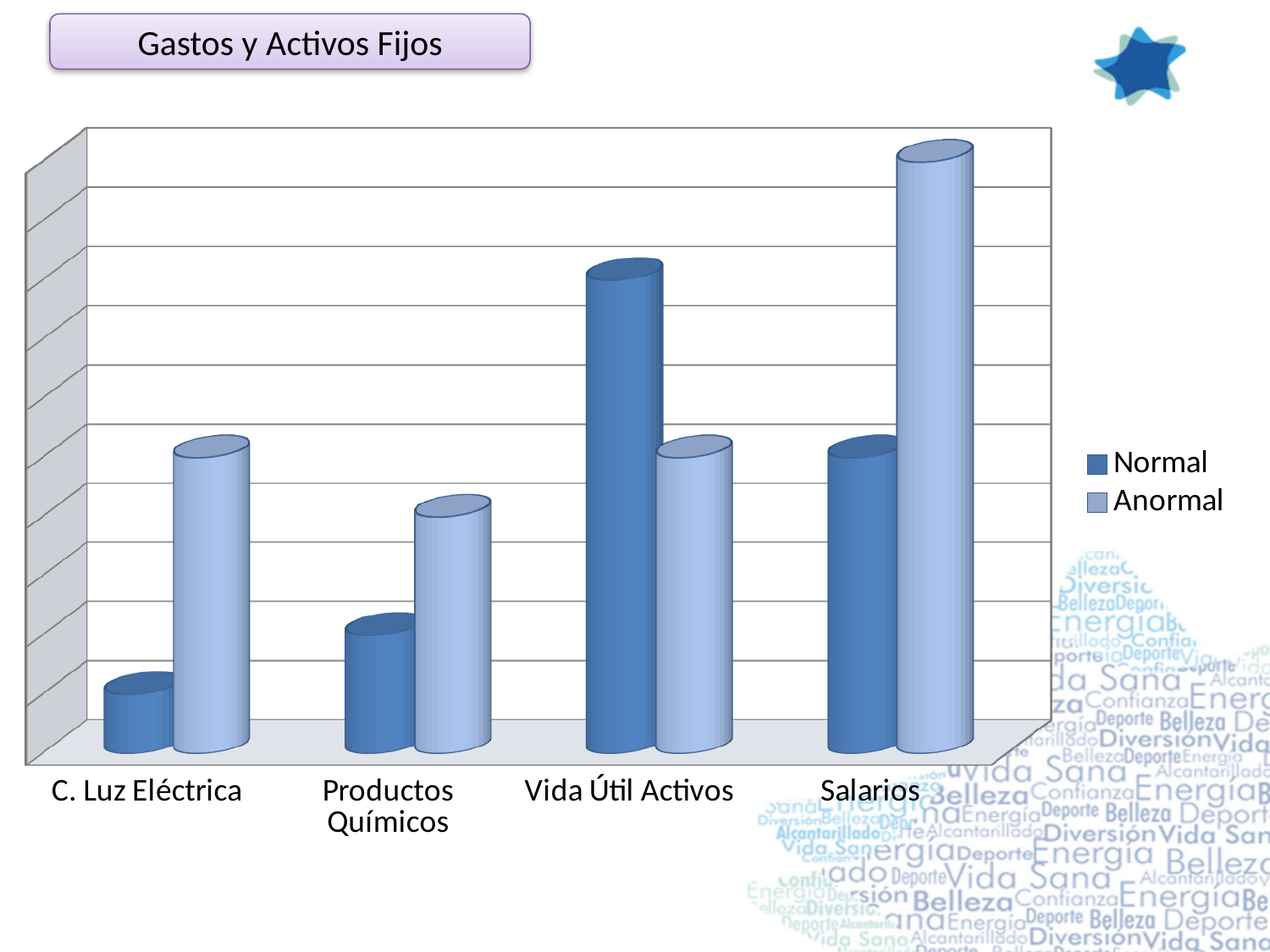
Which category has the highest Normal value? Vida Útil Activos For C. Luz Eléctrica, which is larger, the Normal value or the Anormal value? Anormal What kind of chart is shown on the slide? bar chart Which category has the lowest Normal value? C. Luz Eléctrica What are the two series named in the legend? Normal and Anormal What is the title shown above the chart? Gastos y Activos Fijos Which category has the lowest Anormal value? Productos Químicos How many categories are shown on the x axis of the chart? 4 For Salarios, which is larger, the Normal value or the Anormal value? Anormal For Vida Útil Activos, which is larger, the Normal value or the Anormal value? Normal How many series does the chart's legend list? 2 Which category has the highest Anormal value? Salarios